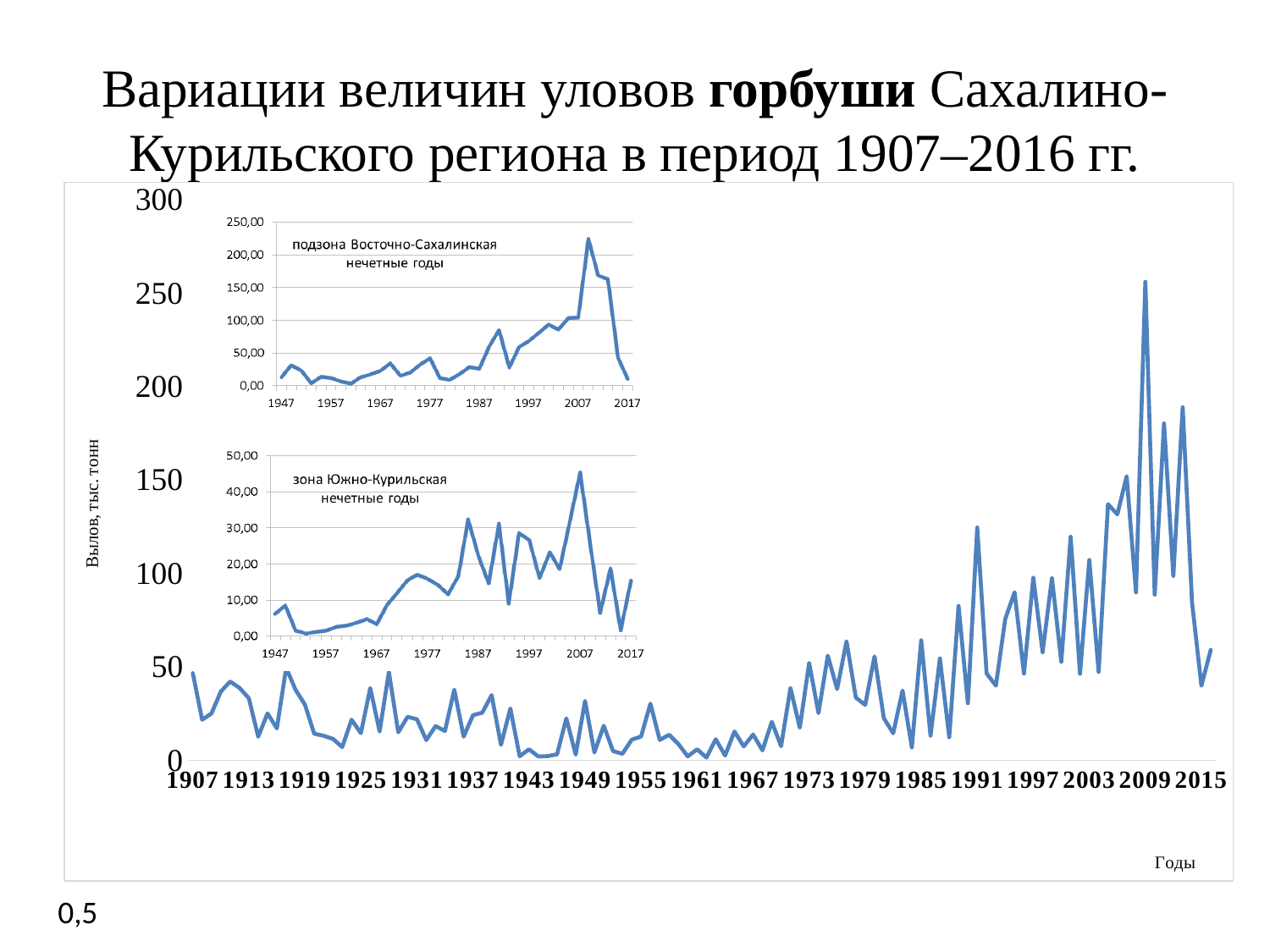
What is the label of the vertical axis on the main chart? Вылов, тыс. тонн On the inset chart 'зона Южно-Курильская нечетные годы', is the value for 1957 greater or less than 10,00? less On the main chart, in which year does the catch reach its highest value? 2009 What kind of chart is the main chart on the slide? line chart On the main chart, is the value for 1991 greater or less than 100? greater On the inset chart 'подзона Восточно-Сахалинская нечетные годы', is the value for 2017 greater or less than 50,00? less On the main chart, do the values generally rise or fall between 1985 and 2009? rise How many data series are plotted on the main chart? 1